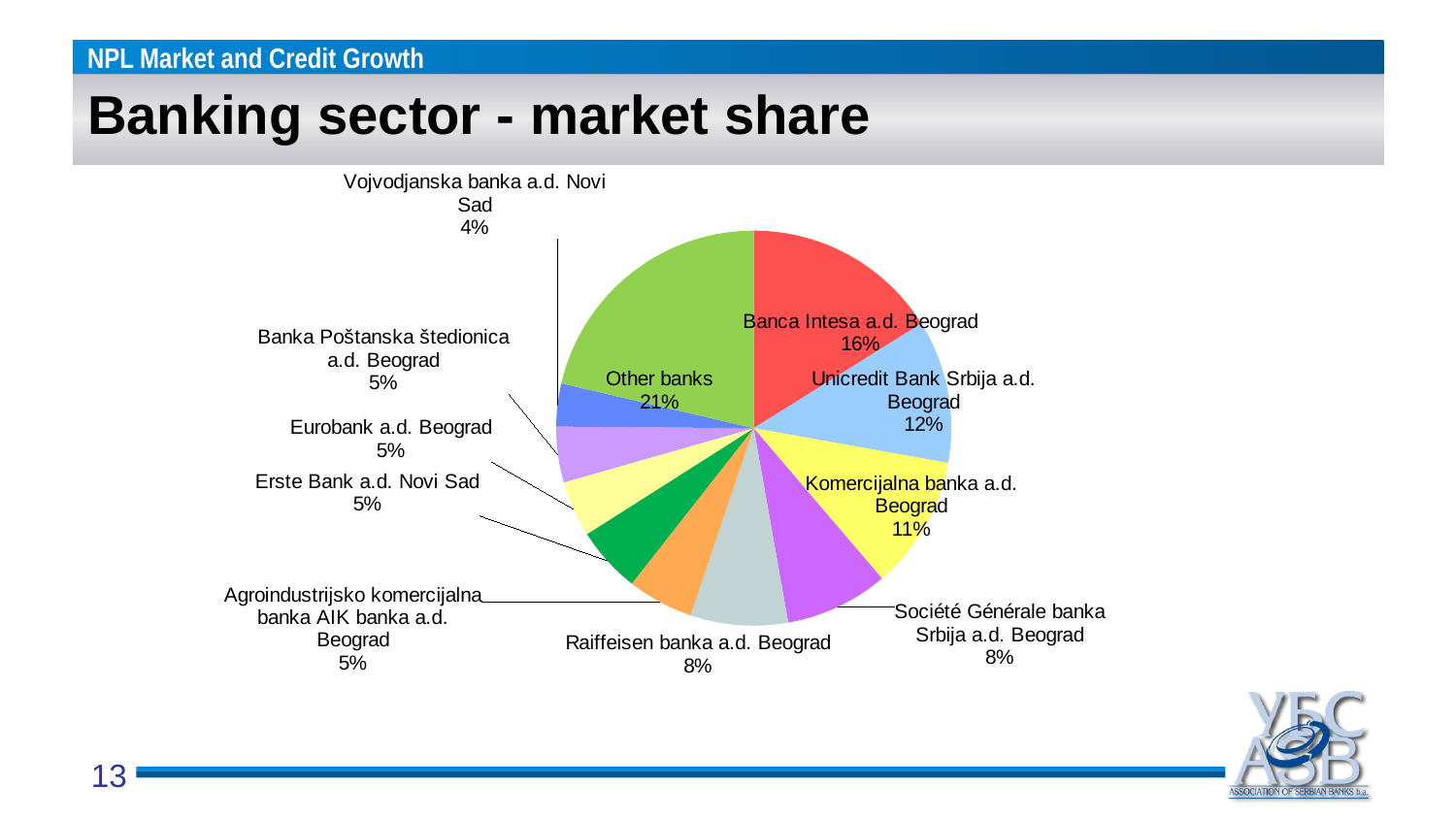
What share is labelled for Other banks? 21% Which slice of the pie is the smallest? Vojvodjanska banka a.d. Novi Sad What is the difference in market share between Banca Intesa a.d. Beograd and Unicredit Bank Srbija a.d. Beograd? 4 percentage points What is the market share of Unicredit Bank Srbija a.d. Beograd? 12% How many slices does the pie chart have? 11 Which has a larger market share, Komercijalna banka a.d. Beograd or Raiffeisen banka a.d. Beograd? Komercijalna banka a.d. Beograd Which slice of the pie is the largest? Other banks Which individually named bank has the largest market share? Banca Intesa a.d. Beograd What percentage is shown for Komercijalna banka a.d. Beograd? 11% What type of chart is shown on the slide? Pie chart What is the market share of Vojvodjanska banka a.d. Novi Sad? 4% What share of the market does Banca Intesa a.d. Beograd hold? 16%